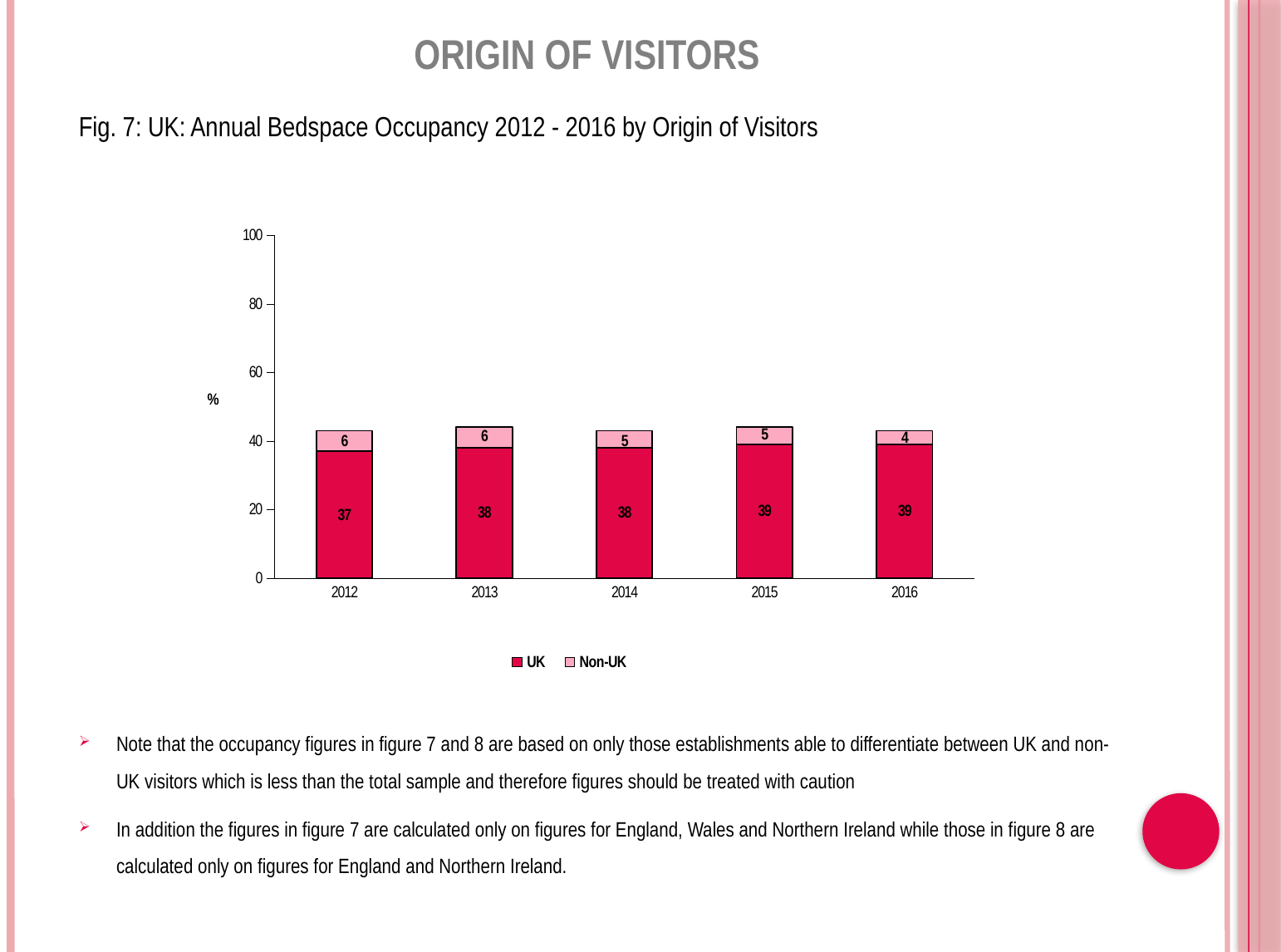
Which year has the lowest UK value? 2012 What is the total of the stacked bar for 2016? 43 How many years are shown on the x axis? 5 What is the total of the stacked bar for 2013? 44 What is the UK value for 2012? 37 What kind of chart is shown? stacked bar chart What is the Non-UK value for 2014? 5 What is the difference between the UK value in 2016 and the UK value in 2012? 2 How many series does the legend list? 2 Is the UK value for 2013 larger or smaller than the UK value for 2015? smaller What is the Non-UK value for 2016? 4 Which year has the lowest Non-UK value? 2016